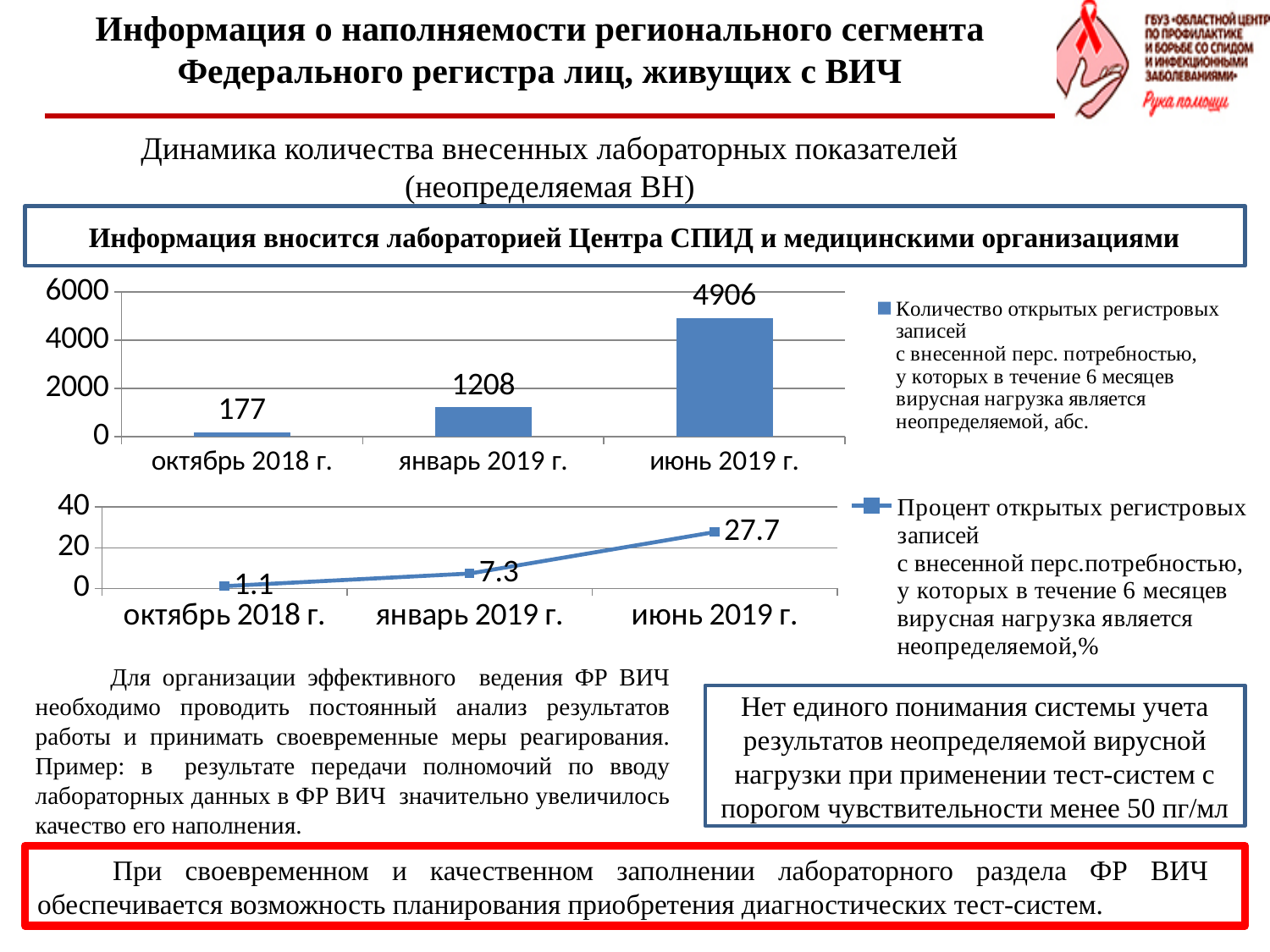
In the top bar chart, what is the difference between the values for июнь 2019 г. and январь 2019 г.? 3698 In the bottom line chart, what is the value for июнь 2019 г.? 27.7 In the top bar chart, which category has the lowest value? октябрь 2018 г. What kind of chart is the top chart on the slide? bar chart In the bottom line chart, which category has the highest value? июнь 2019 г. In the top bar chart, what is the value for январь 2019 г.? 1208 In the bottom line chart, is the value for июнь 2019 г. greater or less than 20? greater In the top bar chart, is the value for январь 2019 г. larger or smaller than the value for октябрь 2018 г.? larger In the bottom line chart, do the values rise or fall from октябрь 2018 г. to июнь 2019 г.? rise In the top bar chart, what is the value for июнь 2019 г.? 4906 In the top bar chart, how many categories are shown on the x axis? 3 In the bottom line chart, what is the value for октябрь 2018 г.? 1.1